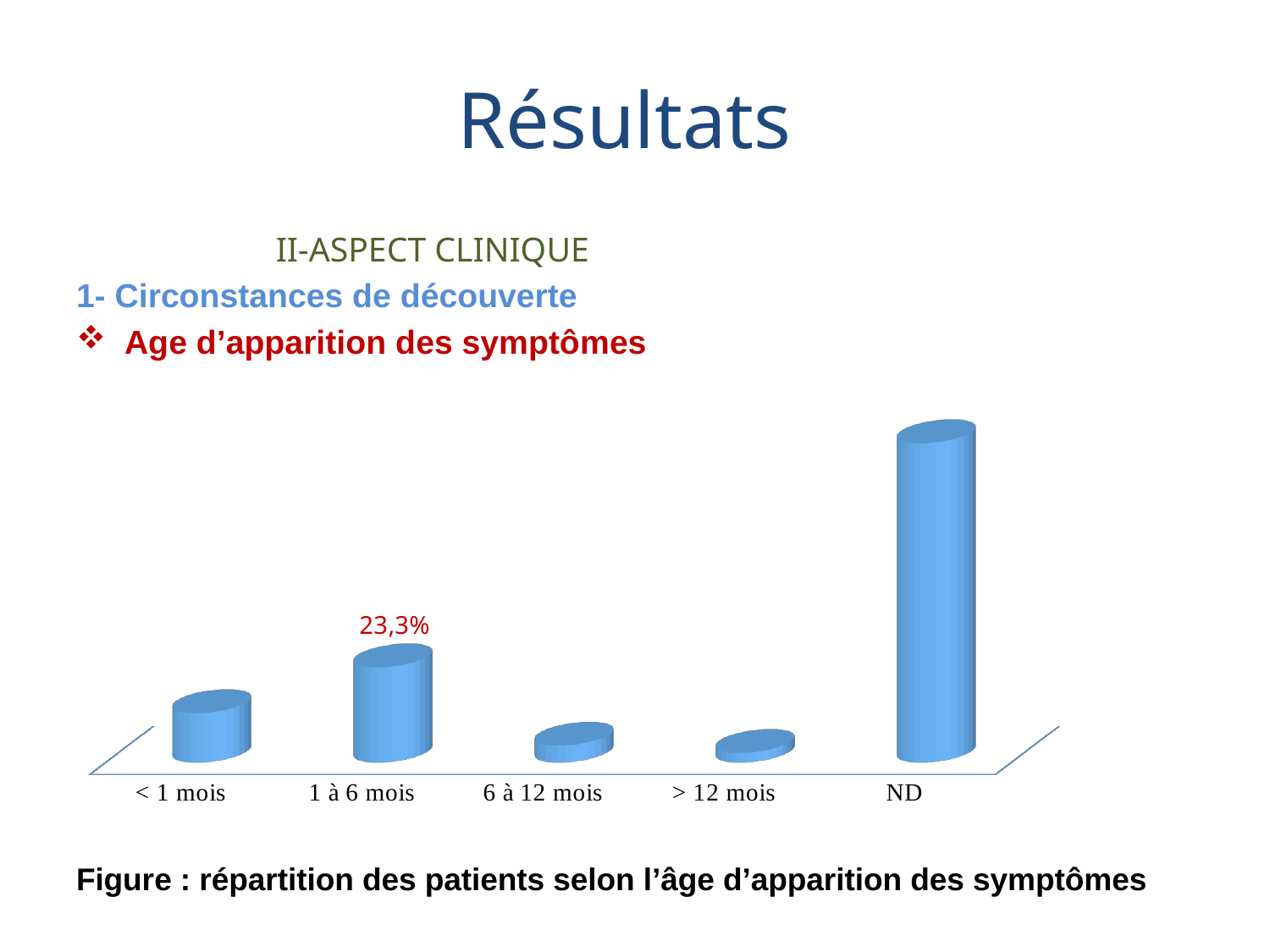
How many categories are shown on the x axis of the chart? 5 Which is larger, the bar for '< 1 mois' or the bar for '1 à 6 mois'? 1 à 6 mois What is the figure caption written below the chart? Figure : répartition des patients selon l'âge d'apparition des symptômes What is the label of the last category on the x axis? ND Which category is the only one with a printed data label? 1 à 6 mois Which is larger, the bar for '< 1 mois' or the bar for '> 12 mois'? < 1 mois What is the value shown for the '1 à 6 mois' category? 23,3% Which is larger, the bar for 'ND' or the bar for '1 à 6 mois'? ND What kind of chart is shown on the slide? Bar chart Which category has the highest bar? ND